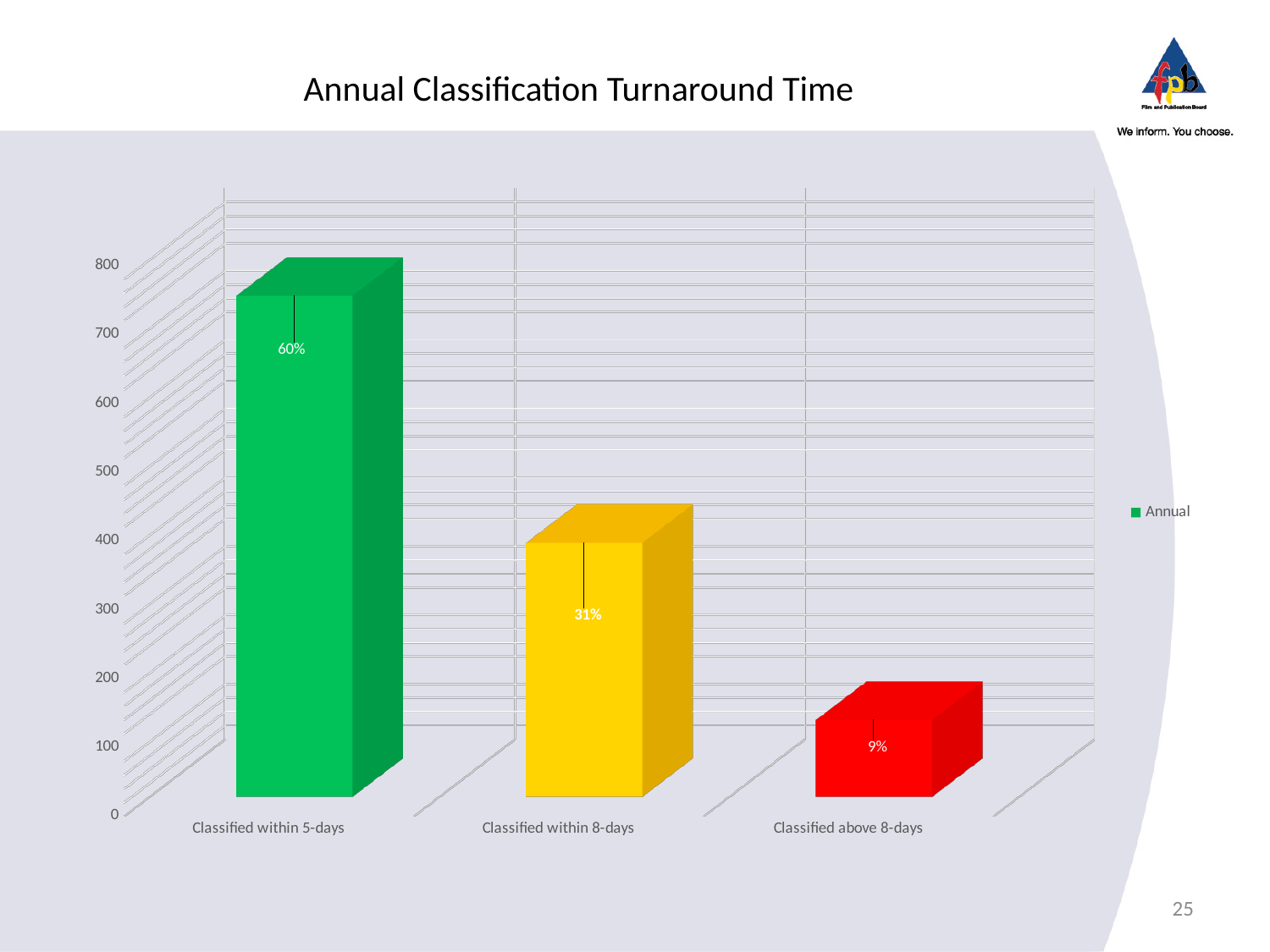
What is the difference between the percentage labels for Classified within 5-days and Classified within 8-days? 29% Which category has the lowest bar? Classified above 8-days What data label is shown on the bar for Classified within 5-days? 60% Is the value for Classified within 5-days greater or less than 700 on the vertical axis? greater What data label is shown on the bar for Classified within 8-days? 31% What data label is shown on the bar for Classified above 8-days? 9% Which is larger, the bar for Classified within 8-days or the bar for Classified above 8-days? Classified within 8-days Which category has the highest bar? Classified within 5-days What kind of chart is shown on the slide? Bar chart Is the value for Classified above 8-days greater or less than 200 on the vertical axis? less How many categories are shown on the chart? 3